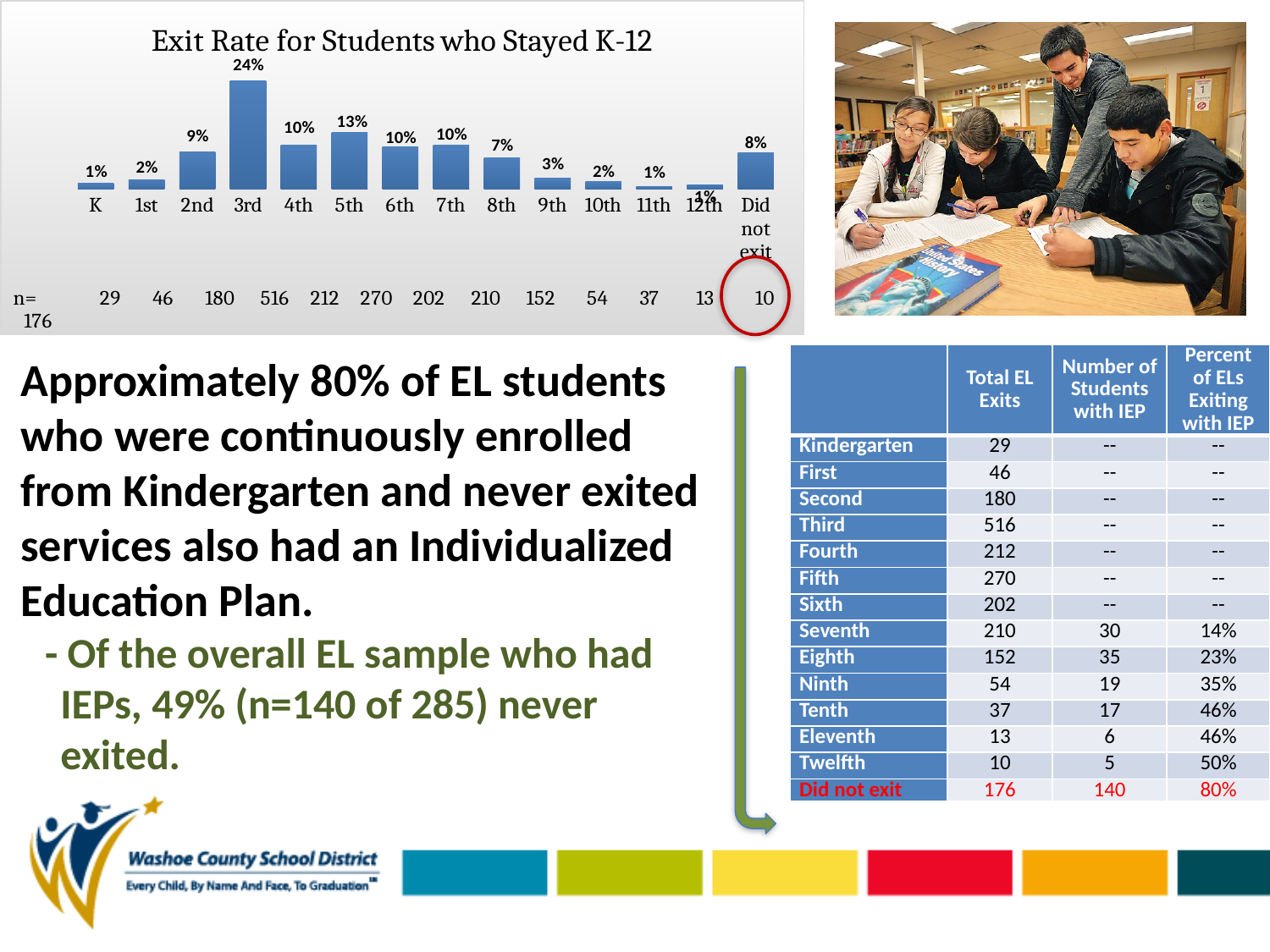
What type of chart is shown on the slide? bar chart Do the exit rates rise or fall from 5th grade to 9th grade? fall What is the exit rate for 3rd grade? 24% What is the exit rate for the 'Did not exit' category? 8% What is the exit rate for 5th grade? 13% What is the exit rate for 2nd grade? 9% How many categories are shown on the x axis of the chart? 14 Which category has the highest exit rate? 3rd What is the difference between the exit rate for 2nd grade and the exit rate for 1st grade? 7% What is the difference between the exit rate for 3rd grade and the exit rate for 5th grade? 11% What is the title of the chart? Exit Rate for Students who Stayed K-12 Which has a higher exit rate, 8th grade or 9th grade? 8th